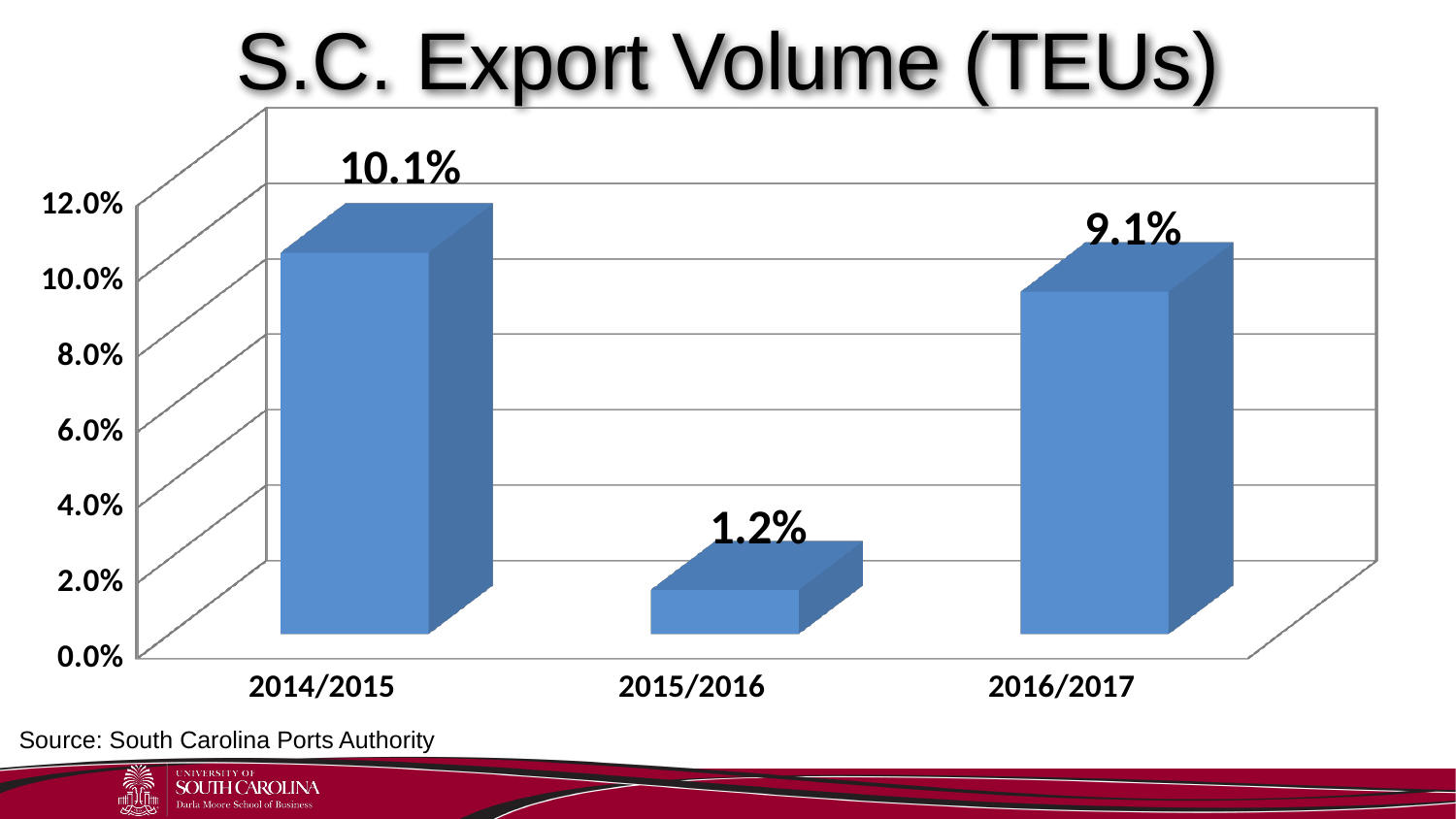
What is the value for 2015/2016? 1.2% What is the value for 2016/2017? 9.1% How many periods are shown on the x axis? 3 Is the value for 2016/2017 greater or less than 8.0%? greater Which period has the highest value? 2014/2015 What is the title of the chart? S.C. Export Volume (TEUs) What is the difference between the values for 2016/2017 and 2015/2016? 7.9% What kind of chart is shown on the slide? bar chart What is the value for 2014/2015? 10.1% Which is larger, the value for 2015/2016 or the value for 2016/2017? 2016/2017 What is the difference between the values for 2014/2015 and 2016/2017? 1.0% Which period has the lowest value? 2015/2016